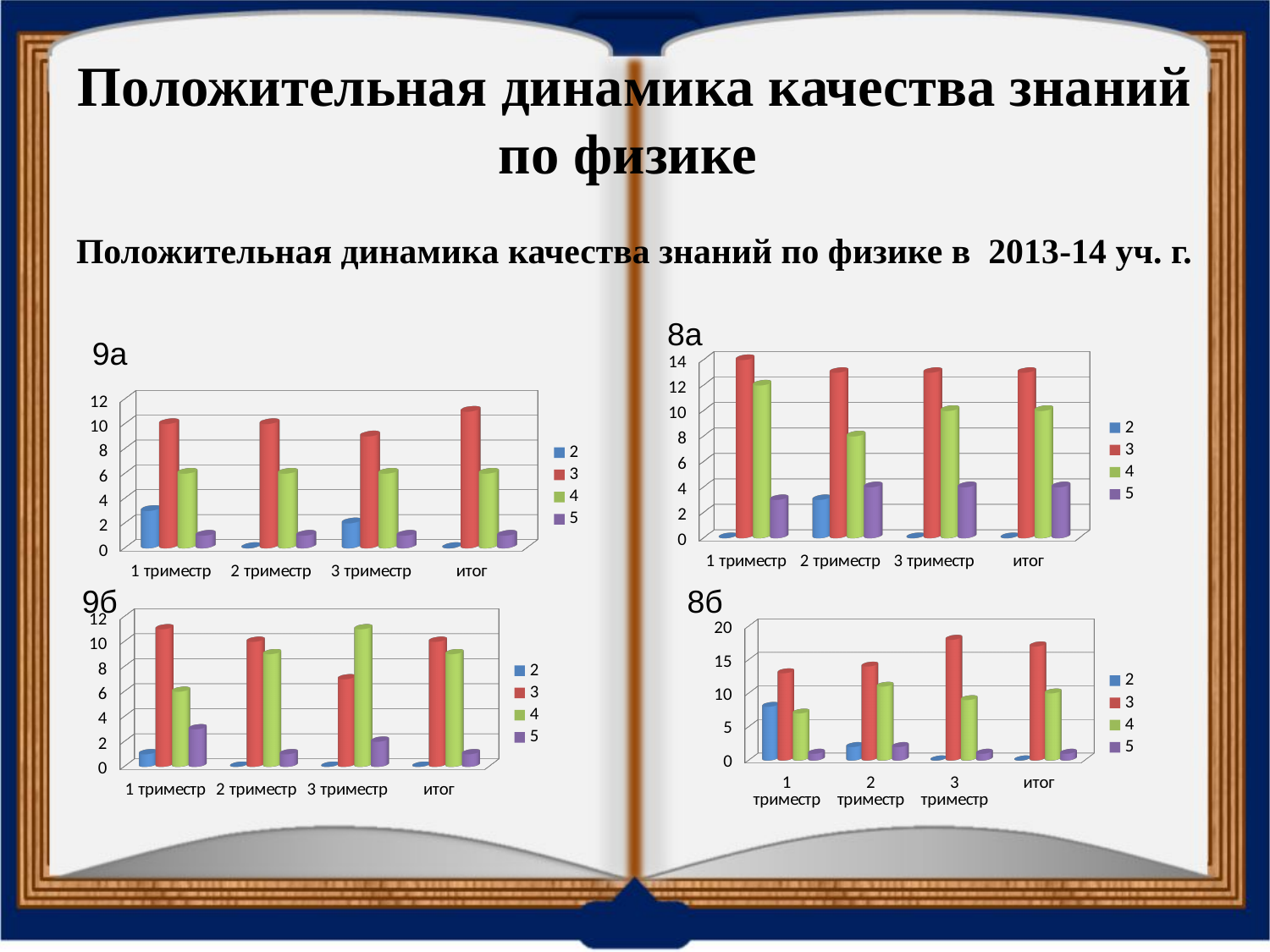
What kind of chart is the 9а chart? bar chart In the 8а chart, is the value for series 4 in 2 триместр greater or less than 10? less In the 9б chart, which is larger in 3 триместр: series 3 or series 4? series 4 In the 8б chart, is the value for series 3 in 3 триместр greater or less than 15? greater What entries does the legend of the 9б chart list? 2, 3, 4, 5 In the 8а chart, which series has the tallest bar in 1 триместр? 3 In the 9а chart, is the value for series 4 in 1 триместр greater or less than 8? less In the 9а chart, which is larger for series 2: 1 триместр or 3 триместр? 1 триместр In the 9б chart, which series has the lowest bar in 2 триместр? 2 How many series does the legend of the 8а chart list? 4 How many categories are shown on the x axis of the 9б chart? 4